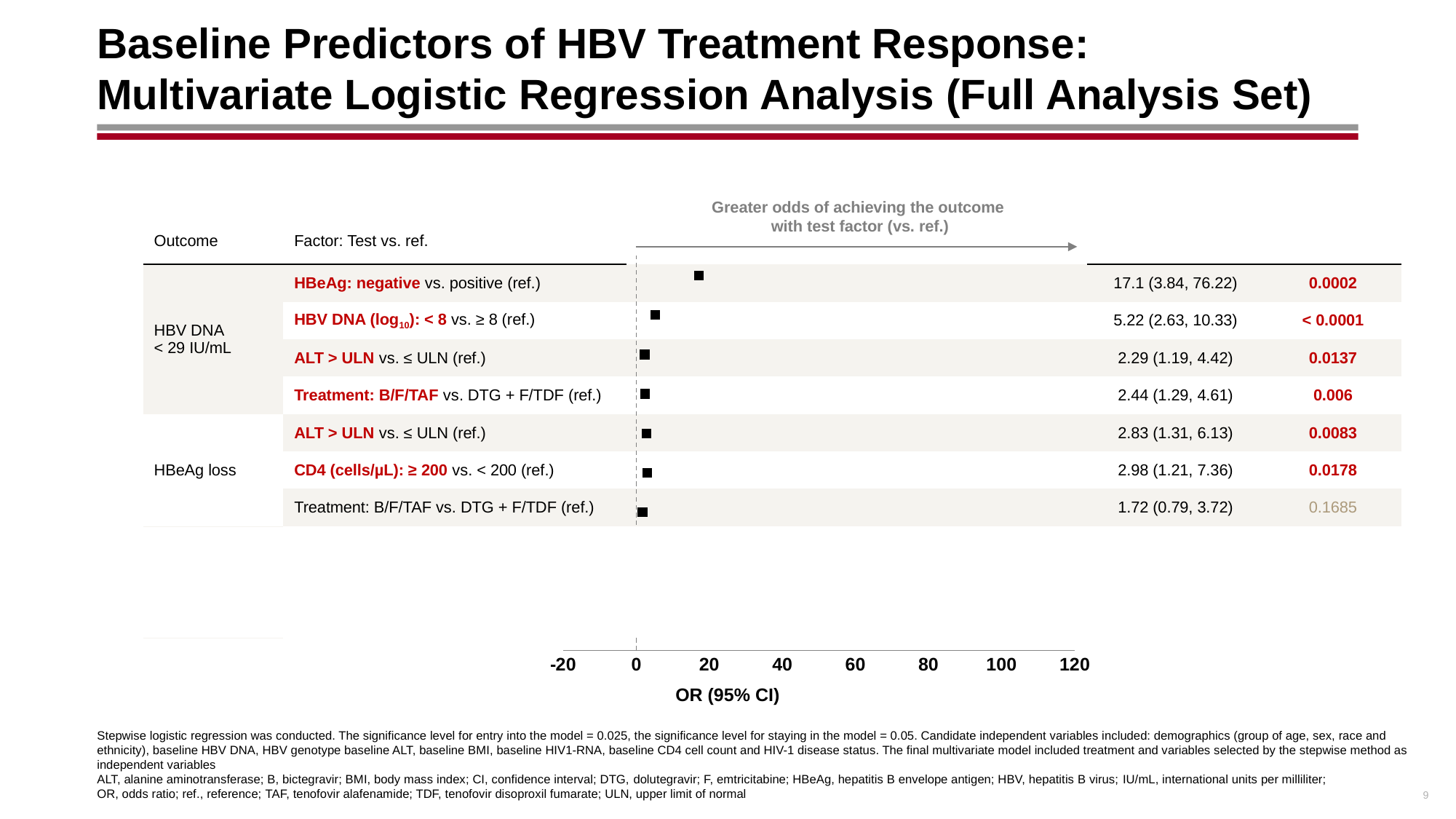
How many factors (data points) are plotted in the chart? 7 What is the p-value for Treatment: B/F/TAF vs. DTG + F/TDF for the outcome HBeAg loss? 0.1685 What is the label of the horizontal axis of the plot? OR (95% CI) Is the odds ratio for HBeAg: negative vs. positive greater or less than 20? less Which factor has the highest odds ratio in the plot? HBeAg: negative vs. positive (ref.) What kind of chart is shown on the slide? Forest plot What is the difference between the odds ratio for HBeAg: negative vs. positive and the odds ratio for HBV DNA (log10): < 8 vs. ≥ 8? 11.88 What is the odds ratio (95% CI) for HBeAg: negative vs. positive for the outcome HBV DNA < 29 IU/mL? 17.1 (3.84, 76.22) Which factor has the lowest odds ratio in the plot? Treatment: B/F/TAF vs. DTG + F/TDF (ref.) for HBeAg loss What is the p-value for HBV DNA (log10): < 8 vs. ≥ 8 for the outcome HBV DNA < 29 IU/mL? < 0.0001 Which has the larger odds ratio: ALT > ULN vs. ≤ ULN for HBV DNA < 29 IU/mL, or ALT > ULN vs. ≤ ULN for HBeAg loss? ALT > ULN vs. ≤ ULN for HBeAg loss What is the odds ratio (95% CI) for CD4 (cells/µL): ≥ 200 vs. < 200 for the outcome HBeAg loss? 2.98 (1.21, 7.36)